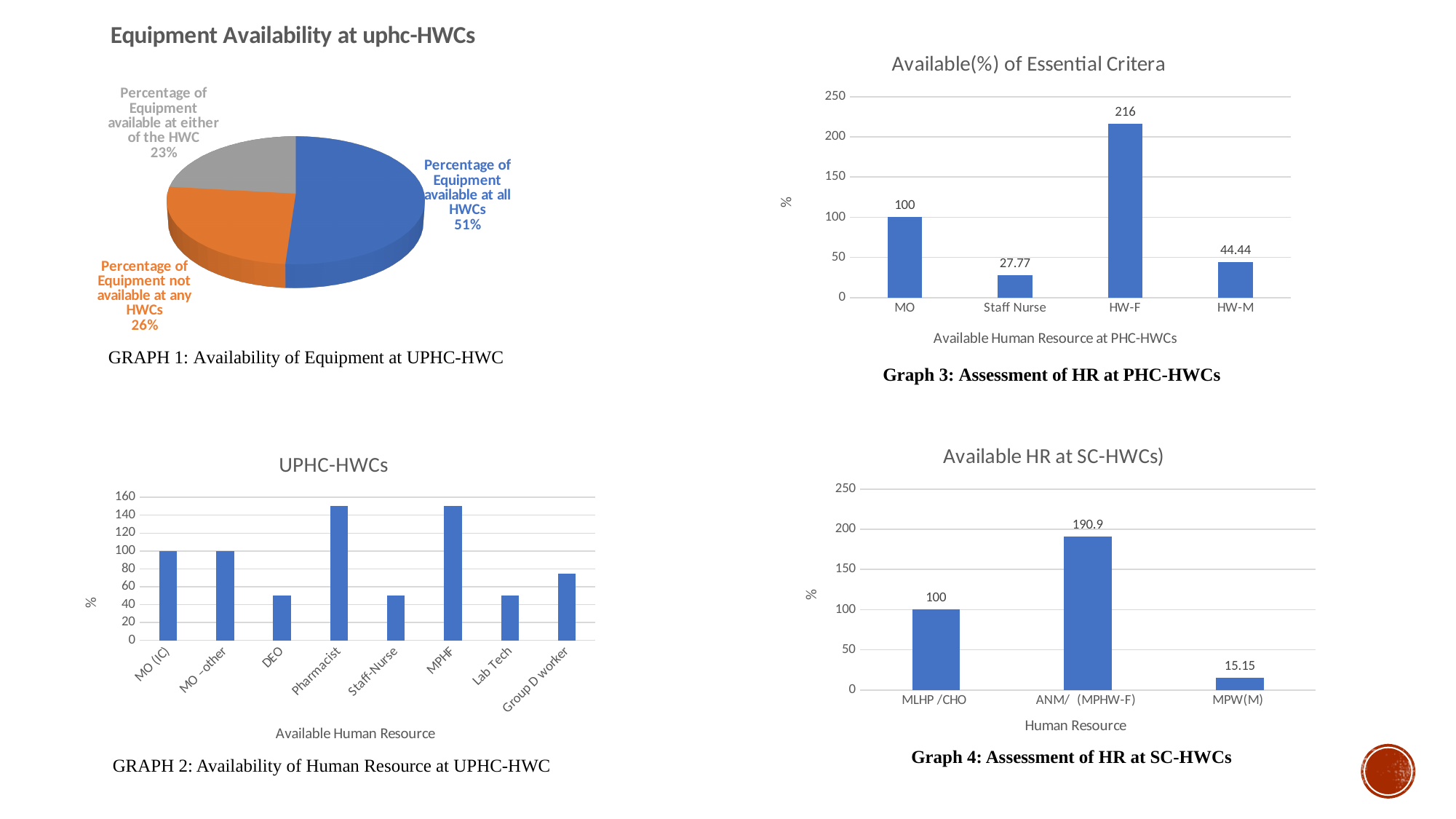
In the pie chart 'Equipment Availability at uphc-HWCs', what share of equipment is available at all HWCs? 51% In the chart 'Available(%) of Essential Critera' (Graph 3), what is the value for HW-F? 216 In the pie chart 'Equipment Availability at uphc-HWCs', which slice is the smallest? Percentage of Equipment available at either of the HWC In the chart 'Available HR at SC-HWCs)' (Graph 4), what is the value for MPW(M)? 15.15 In the chart 'Available HR at SC-HWCs)' (Graph 4), how many categories are shown on the x axis? 3 In the chart 'Available(%) of Essential Critera' (Graph 3), which category has the lowest value? Staff Nurse In the chart 'UPHC-HWCs' (Graph 2), is the value for Pharmacist greater or less than 140? greater In the pie chart 'Equipment Availability at uphc-HWCs', how many slices are there? 3 In the chart 'Available HR at SC-HWCs)' (Graph 4), which category has the highest value? ANM/ (MPHW-F) In the chart 'Available(%) of Essential Critera' (Graph 3), what is the difference between the values for HW-F and MO? 116 In the chart 'UPHC-HWCs' (Graph 2), which is larger, the value for DEO or the value for Group D worker? Group D worker What kind of chart is 'UPHC-HWCs' (Graph 2)? bar chart